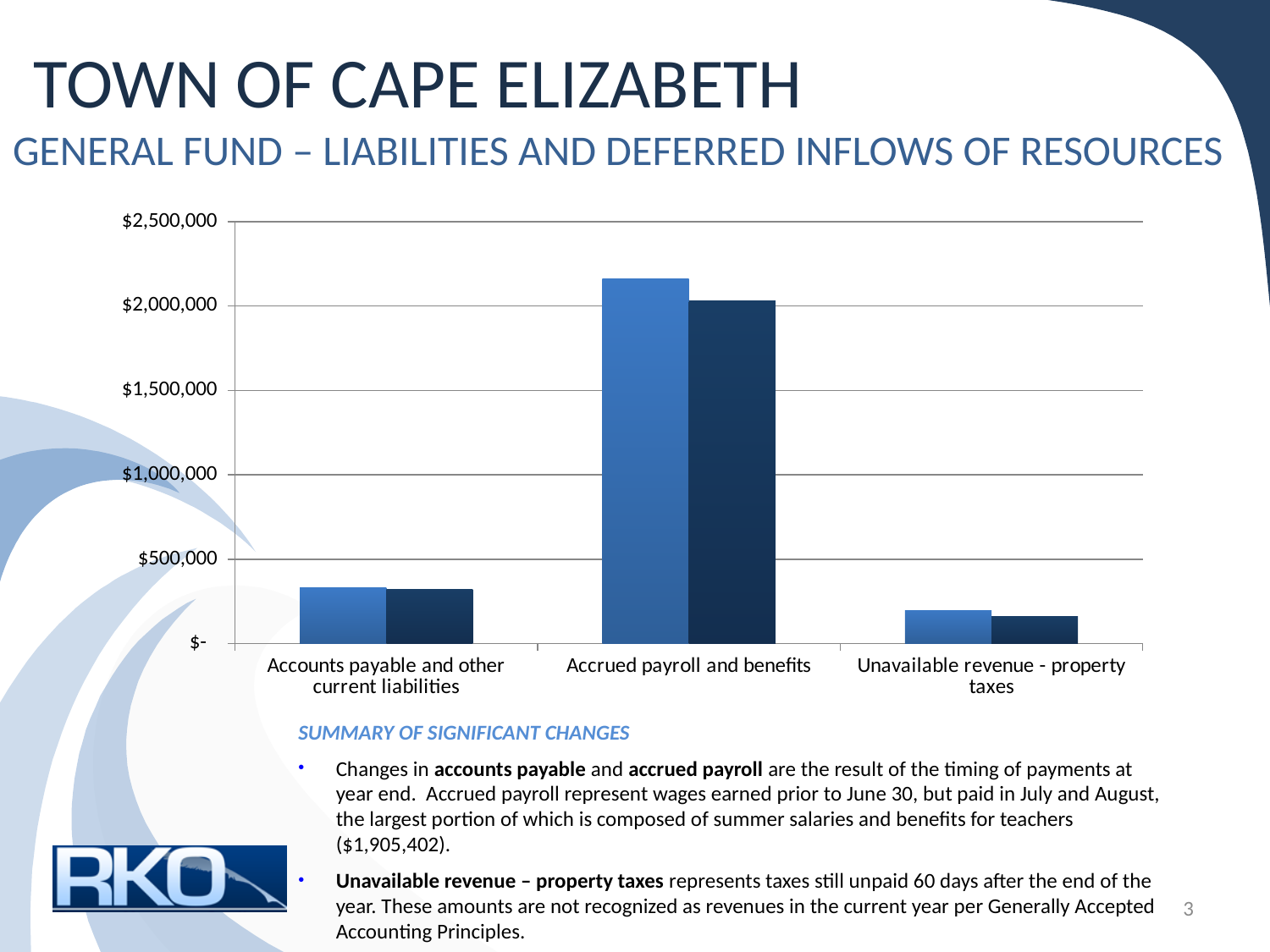
How many categories are shown on the x axis of the chart? 3 Which category has the highest bars in the chart? Accrued payroll and benefits Which category has the lowest bars in the chart? Unavailable revenue - property taxes What kind of chart is shown on the slide? bar chart Which is larger for Accrued payroll and benefits: the lighter blue bar or the darker blue bar? the lighter blue bar Is the value of the lighter blue bar for Accrued payroll and benefits greater or less than $2,000,000? greater Which is larger: the lighter blue bar for Accounts payable and other current liabilities or the lighter blue bar for Unavailable revenue - property taxes? Accounts payable and other current liabilities How many bars are shown for each category in the chart? 2 Is the value of the lighter blue bar for Accounts payable and other current liabilities greater or less than $500,000? less What is the highest value labelled on the vertical axis of the chart? $2,500,000 Is the value of the darker blue bar for Unavailable revenue - property taxes greater or less than $500,000? less